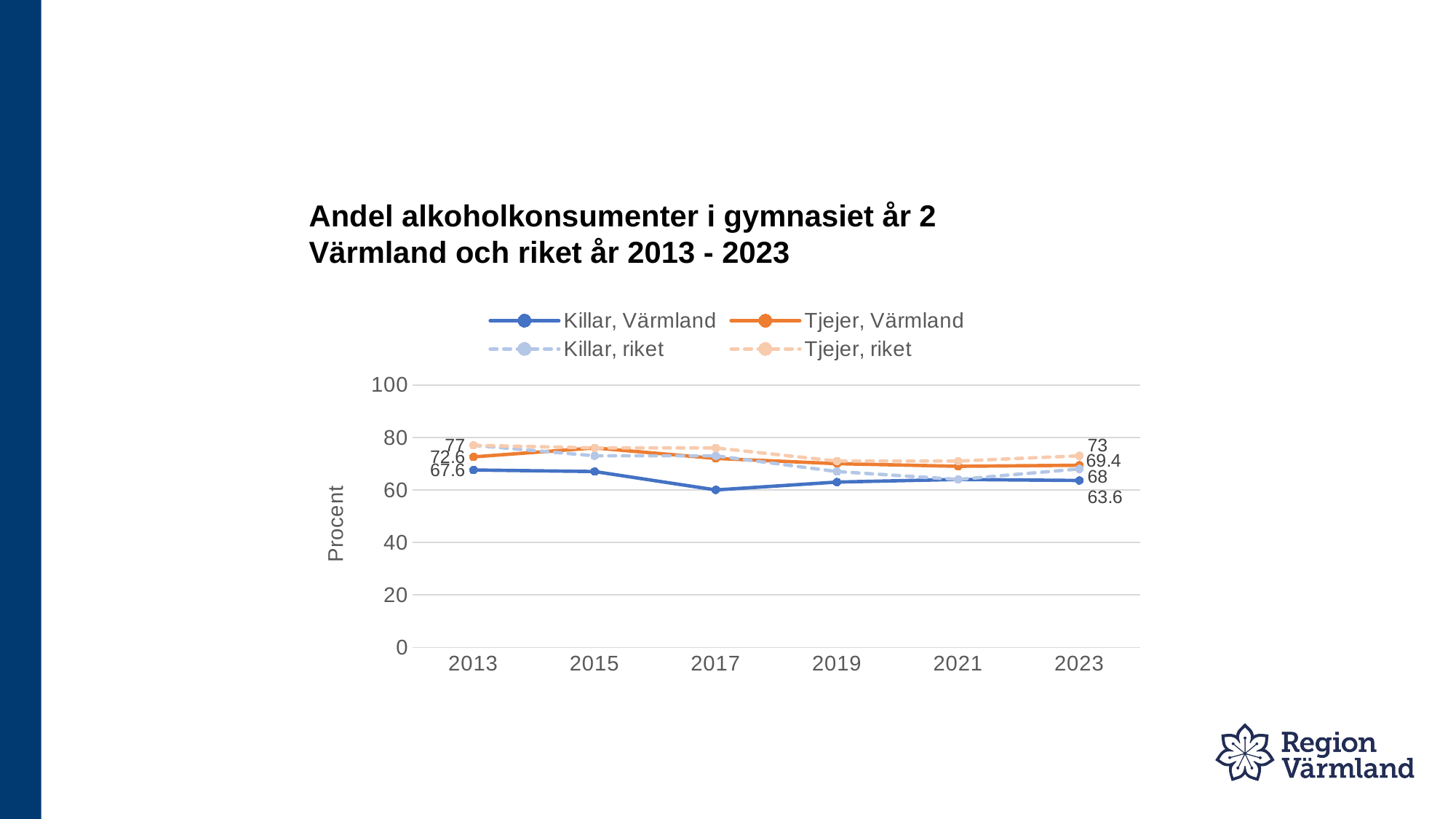
What is the value for Killar, riket in 2023? 68 What is the value for Killar, Värmland in 2013? 67.6 By how much did the value for Killar, Värmland change between 2013 and 2023? 4 Is the value for Killar, Värmland in 2017 greater or less than 80? less What is the value for Killar, Värmland in 2023? 63.6 How many years are plotted along the x axis? 6 How many series does the legend list? 4 Which series has the lowest value in 2023? Killar, Värmland What type of chart is shown on the slide? line chart What is the value for Tjejer, riket in 2023? 73 What is the label on the y axis? Procent What is the value for Tjejer, Värmland in 2023? 69.4